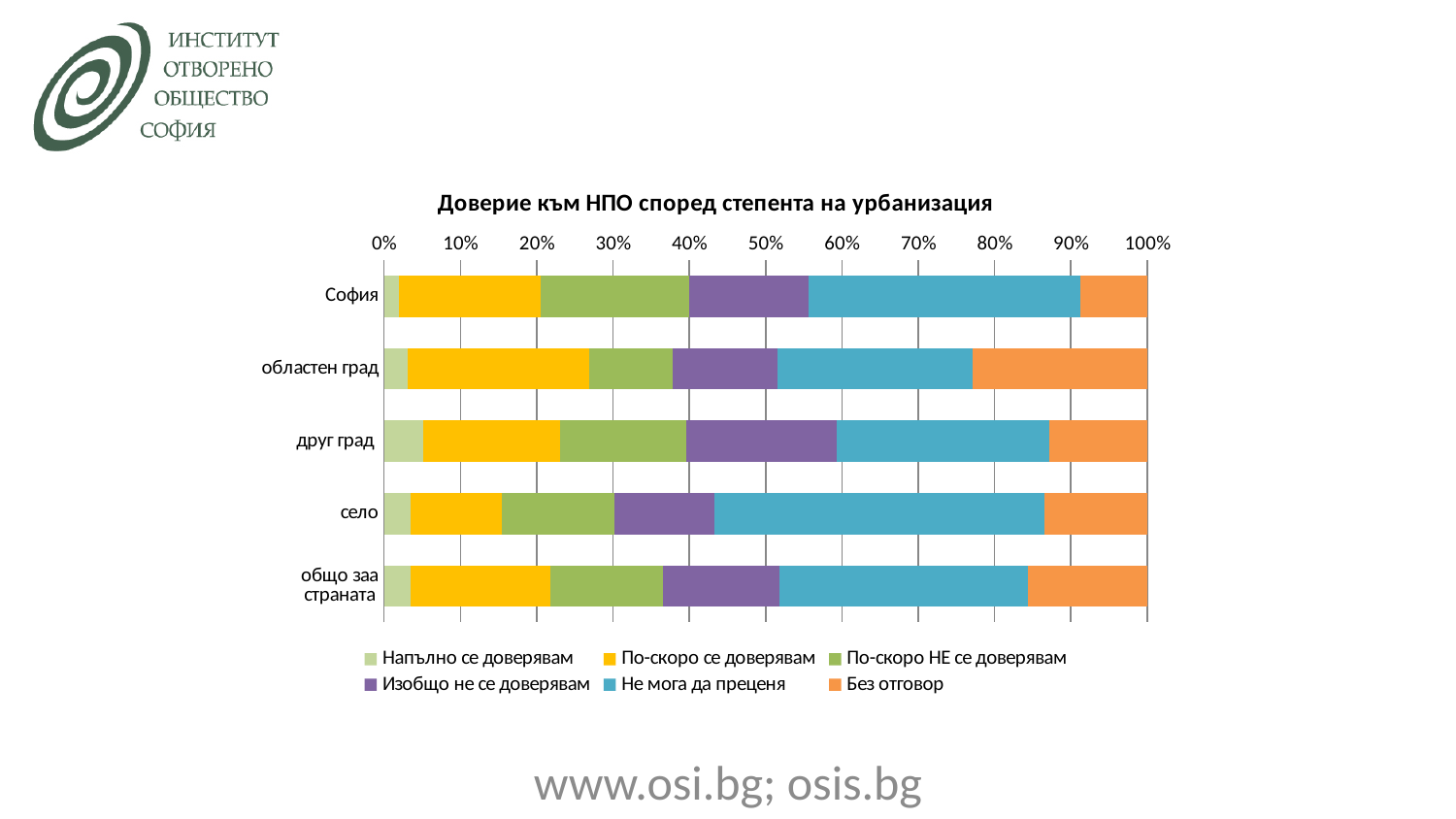
What kind of chart is shown on the slide? stacked bar chart Which is larger: the 'Не мога да преценя' segment for София or for областен град? София Which series is shown in orange in the legend? Без отговор How many series does the legend list? 6 Is the value of 'Напълно се доверявам' for София greater or less than 10%? less Which category has the largest 'Без отговор' segment? областен град Is the value of 'Не мога да преценя' for София greater or less than 30%? greater What is the title of the chart? Доверие към НПО според степента на урбанизация Is the value of 'Без отговор' for областен град greater or less than 10%? greater Which is larger: the 'По-скоро се доверявам' segment for областен град or for село? областен град Which category has the smallest 'Без отговор' segment? София How many categories (rows) are plotted on the chart? 5